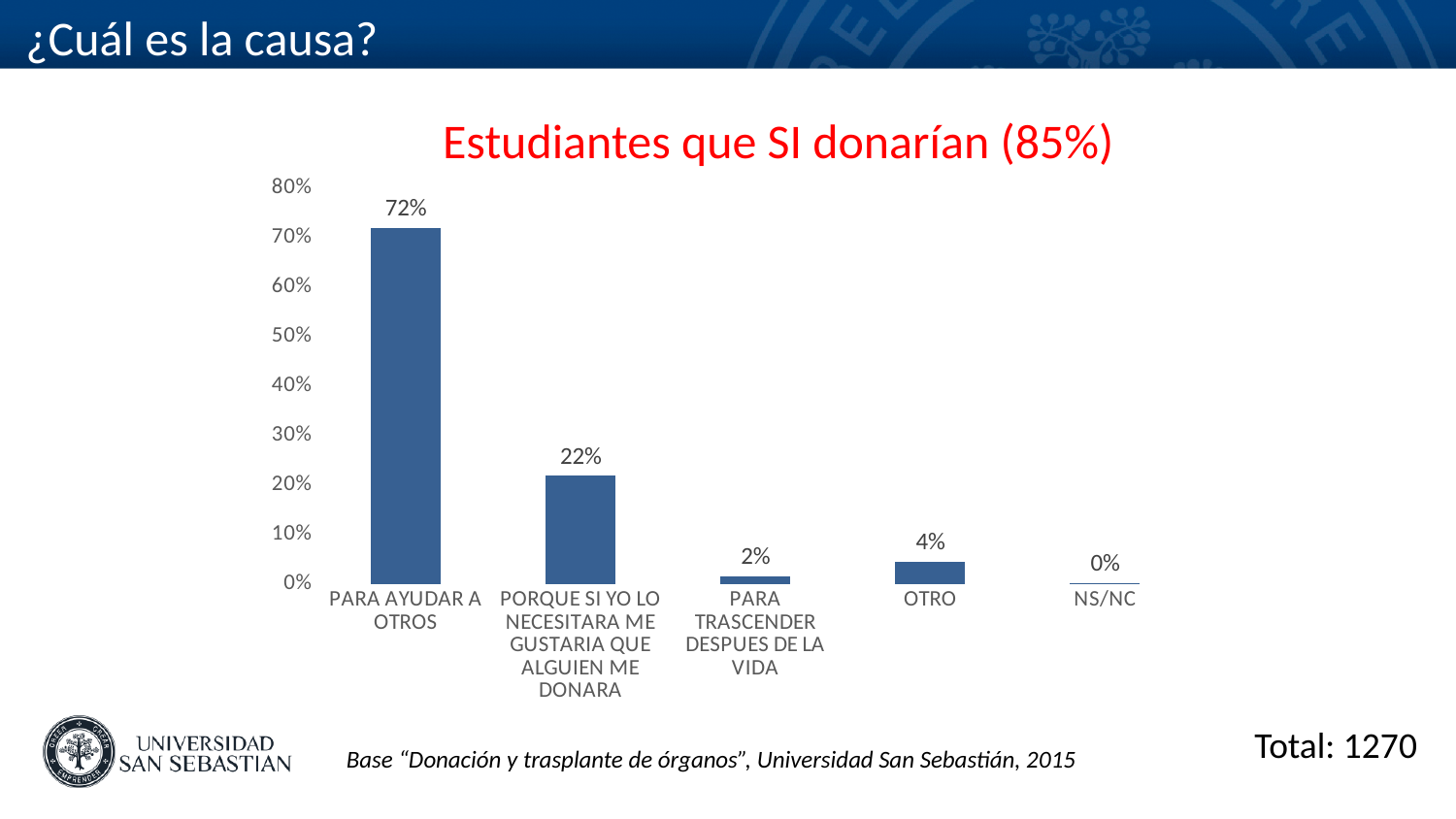
What is the value for PARA TRASCENDER DESPUES DE LA VIDA? 2% Which is larger, the value for OTRO or the value for PARA TRASCENDER DESPUES DE LA VIDA? OTRO What is the title of the chart? Estudiantes que SI donarían (85%) What kind of chart is shown on the slide? bar chart What is the value for NS/NC? 0% What is the value for PORQUE SI YO LO NECESITARA ME GUSTARIA QUE ALGUIEN ME DONARA? 22% Which category has the lowest value? NS/NC Which category has the highest value? PARA AYUDAR A OTROS What is the difference between the values for PARA AYUDAR A OTROS and PORQUE SI YO LO NECESITARA ME GUSTARIA QUE ALGUIEN ME DONARA? 50% What is the value for PARA AYUDAR A OTROS? 72% How many categories are shown on the x axis? 5 What is the value for OTRO? 4%